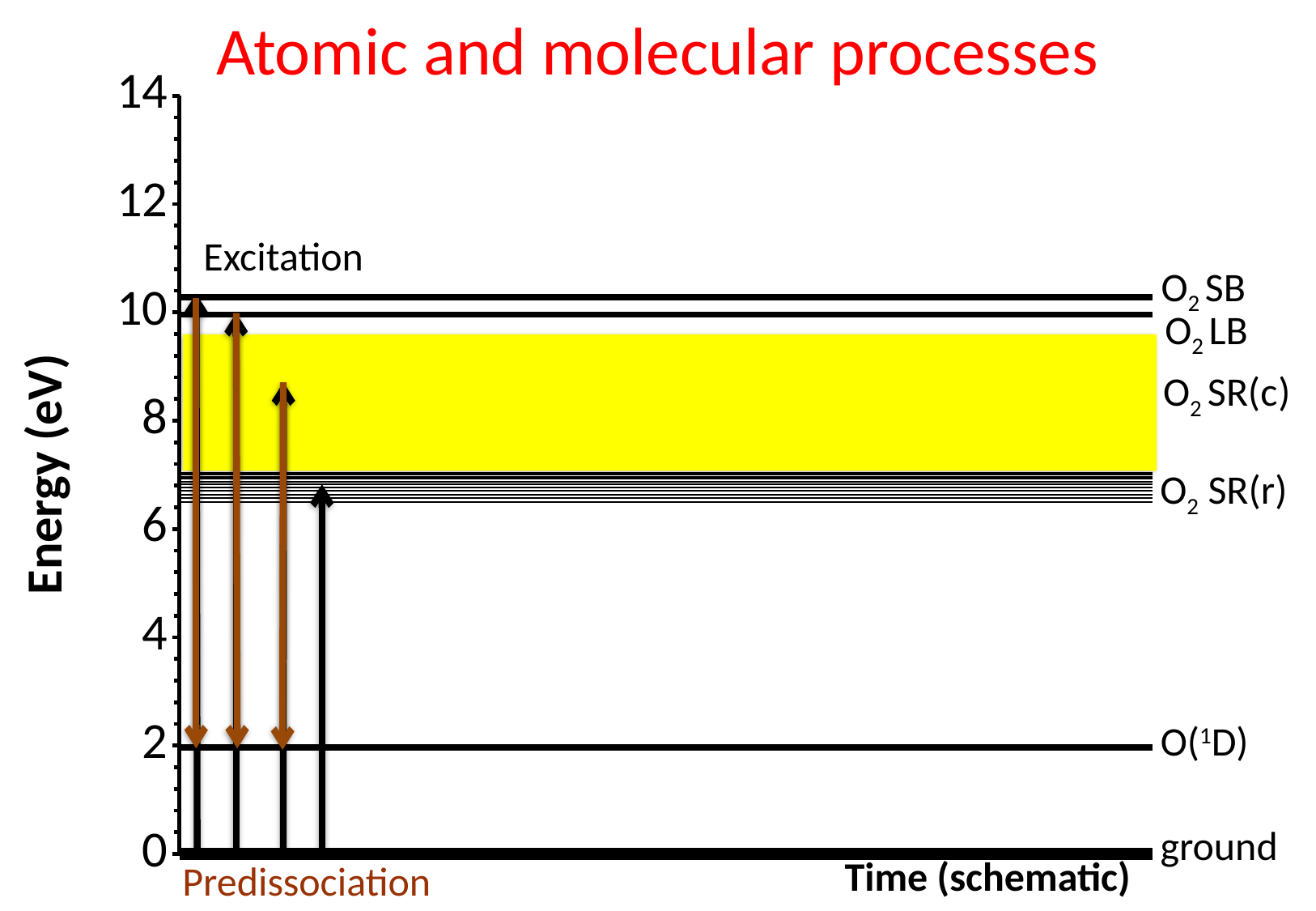
Is the energy of the O2 SB level greater or less than 10? greater Which labelled energy level is the lowest on the chart? ground Which level is at a higher energy, O2 SB or O(1D)? O2 SB Which labelled energy level is the highest on the chart? O2 SB What is the title of the chart? Atomic and molecular processes Is the energy of the O2 LB level greater or less than 8? greater What is the label of the vertical axis? Energy (eV) At what energy is the ground level drawn? 0 How many labelled energy levels are shown on the chart? 6 Is the energy of the O2 SR(r) level greater or less than 6? greater At what energy is the O(1D) level drawn? 2 How many vertical transition arrows are drawn on the chart? 4